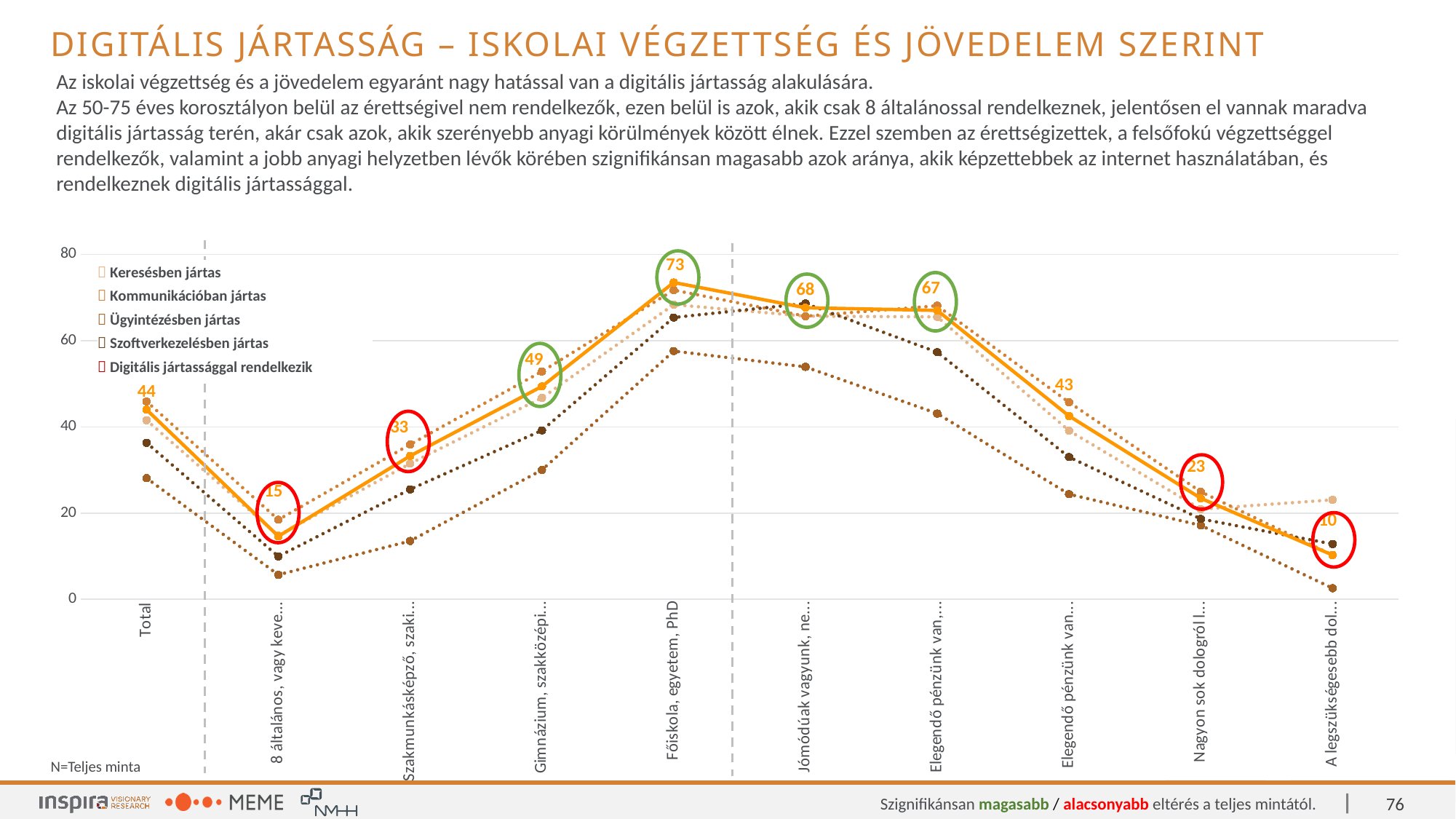
What is the value for Nagyon sok dologról for the Digitális jártassággal rendelkezik series? 23 How many series does the legend list? 5 Which category has the highest value for the Digitális jártassággal rendelkezik series? Főiskola, egyetem, PhD What is the value for Total for the Digitális jártassággal rendelkezik series? 44 Do the Digitális jártassággal rendelkezik values rise or fall from 8 általános to Főiskola, egyetem, PhD? Rise Which category has the lowest value for the Digitális jártassággal rendelkezik series? A legszükségesebb dol... Which has the larger Digitális jártassággal rendelkezik value: Gimnázium or Szakmunkásképző? Gimnázium How many categories are shown on the x axis? 10 What is the difference between the Digitális jártassággal rendelkezik values for Főiskola, egyetem, PhD and 8 általános? 58 What is the value for Jómódúak vagyunk for the Digitális jártassággal rendelkezik series? 68 What kind of chart is shown on the slide? Line chart What is the value for Főiskola, egyetem, PhD for the Digitális jártassággal rendelkezik series? 73